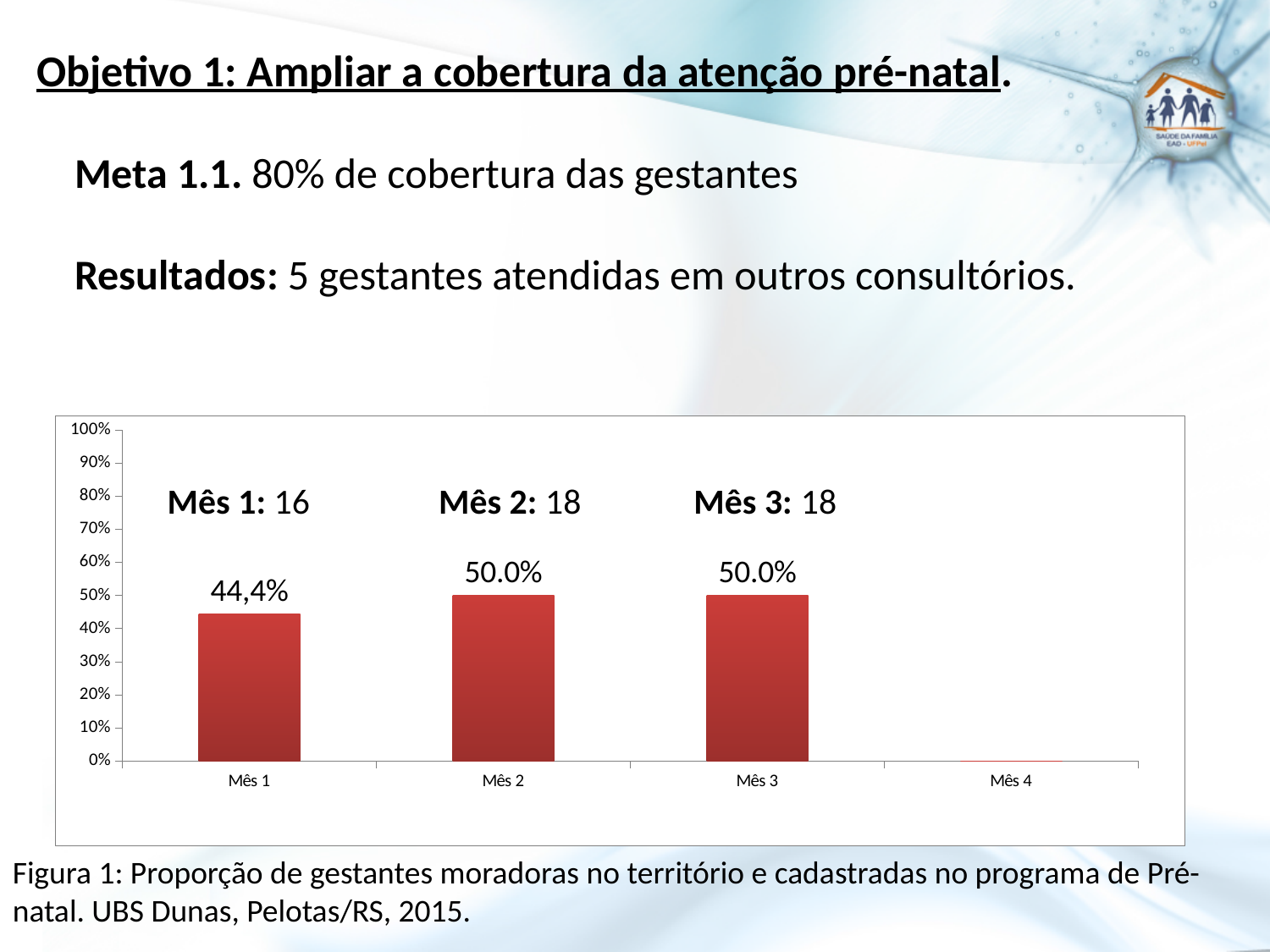
Is the value for Mês 3 greater or less than 40%? greater How many categories are labelled on the x axis of the chart? 4 What is the value shown for Mês 1 in the chart? 44,4% What is the value shown for Mês 2 in the chart? 50.0% Does the value rise or fall from Mês 1 to Mês 2? rise Which is larger in the chart, the value for Mês 1 or the value for Mês 2? Mês 2 Among the bars plotted in the chart, which month has the lowest value? Mês 1 What is the value shown for Mês 3 in the chart? 50.0% How many bars are actually plotted in the chart? 3 According to the annotation inside the chart, how many gestantes are listed for Mês 2? 18 Is the value for Mês 1 greater or less than 50%? less What kind of chart is shown on the slide? bar chart